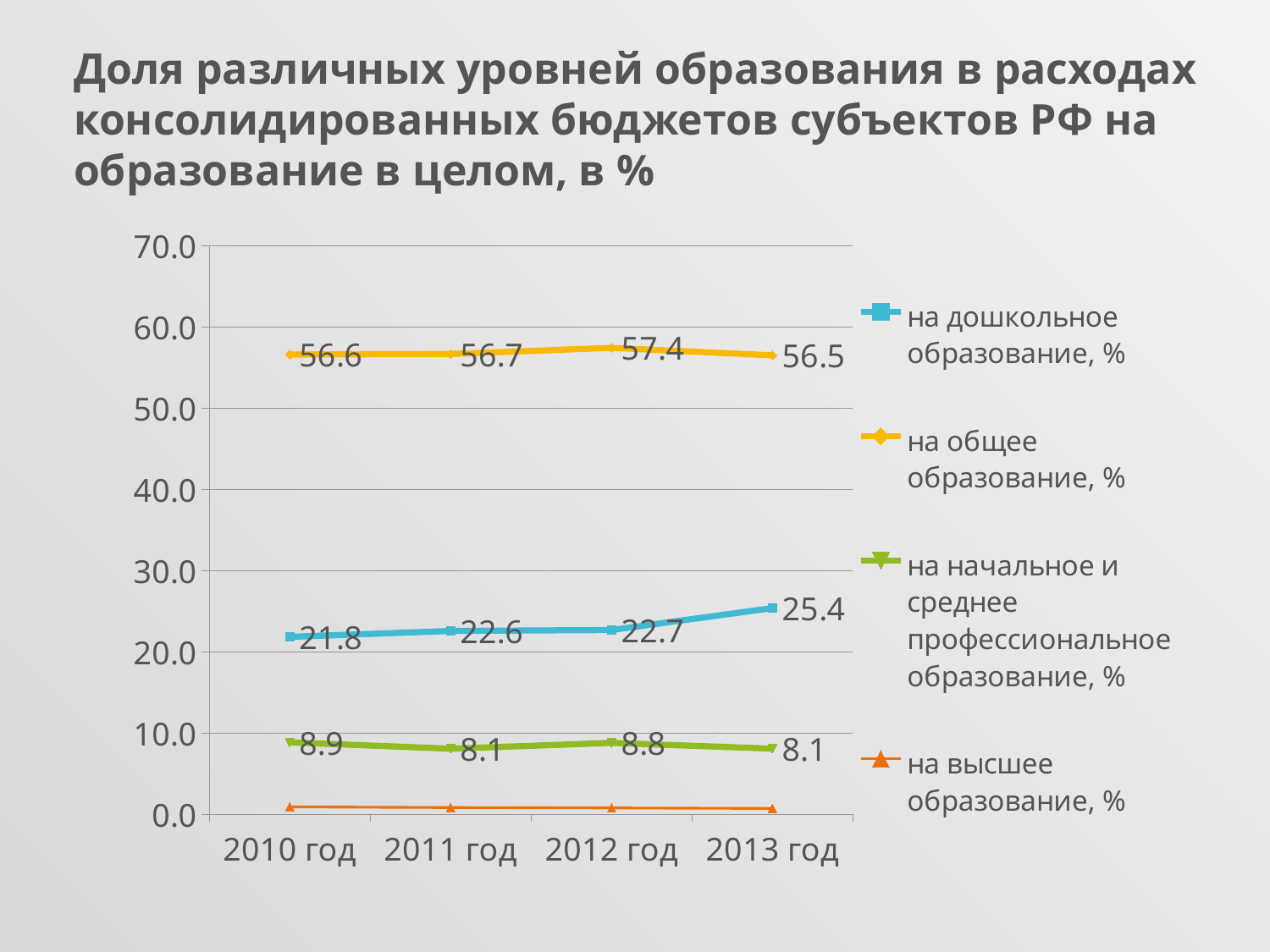
Which series has the highest values across all years? на общее образование, % Is the value for 'на высшее образование, %' in 2011 год greater or less than 10.0? less In which year is the value for 'на дошкольное образование, %' lowest? 2010 год How many series does the legend list? 4 What is the difference between the 2013 год and 2010 год values for 'на дошкольное образование, %'? 3.6 What is the value for 'на общее образование, %' in 2012 год? 57.4 In which year is the value for 'на общее образование, %' highest? 2012 год What type of chart is shown on the slide? line chart How many years are shown on the x axis? 4 What is the value for 'на дошкольное образование, %' in 2013 год? 25.4 Does the value for 'на дошкольное образование, %' rise or fall from 2010 год to 2013 год? rise What is the value for 'на начальное и среднее профессиональное образование, %' in 2010 год? 8.9